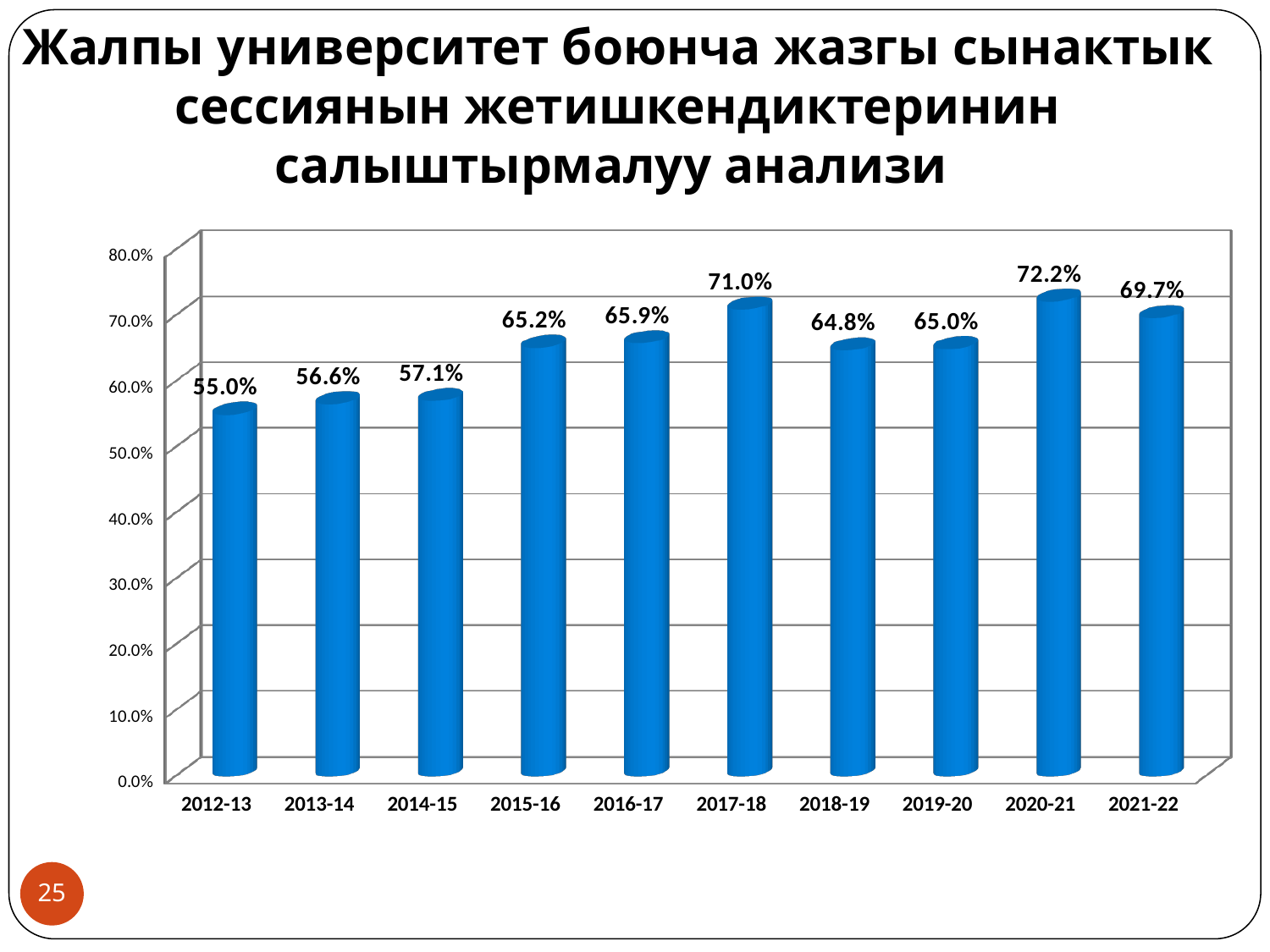
What is the value for 2017-18? 71.0% Which year has the lowest value? 2012-13 Which year has the highest value? 2020-21 What is the value for 2012-13? 55.0% What is the difference between the values for 2021-22 and 2020-21? 2.5% What kind of chart is shown on the slide? bar chart Is the value for 2014-15 greater or less than 60.0%? less Which is larger, the value for 2015-16 or the value for 2018-19? 2015-16 What is the difference between the values for 2020-21 and 2012-13? 17.2% How many years are shown on the x axis? 10 What colour are the bars in the chart? blue What is the value for 2021-22? 69.7%